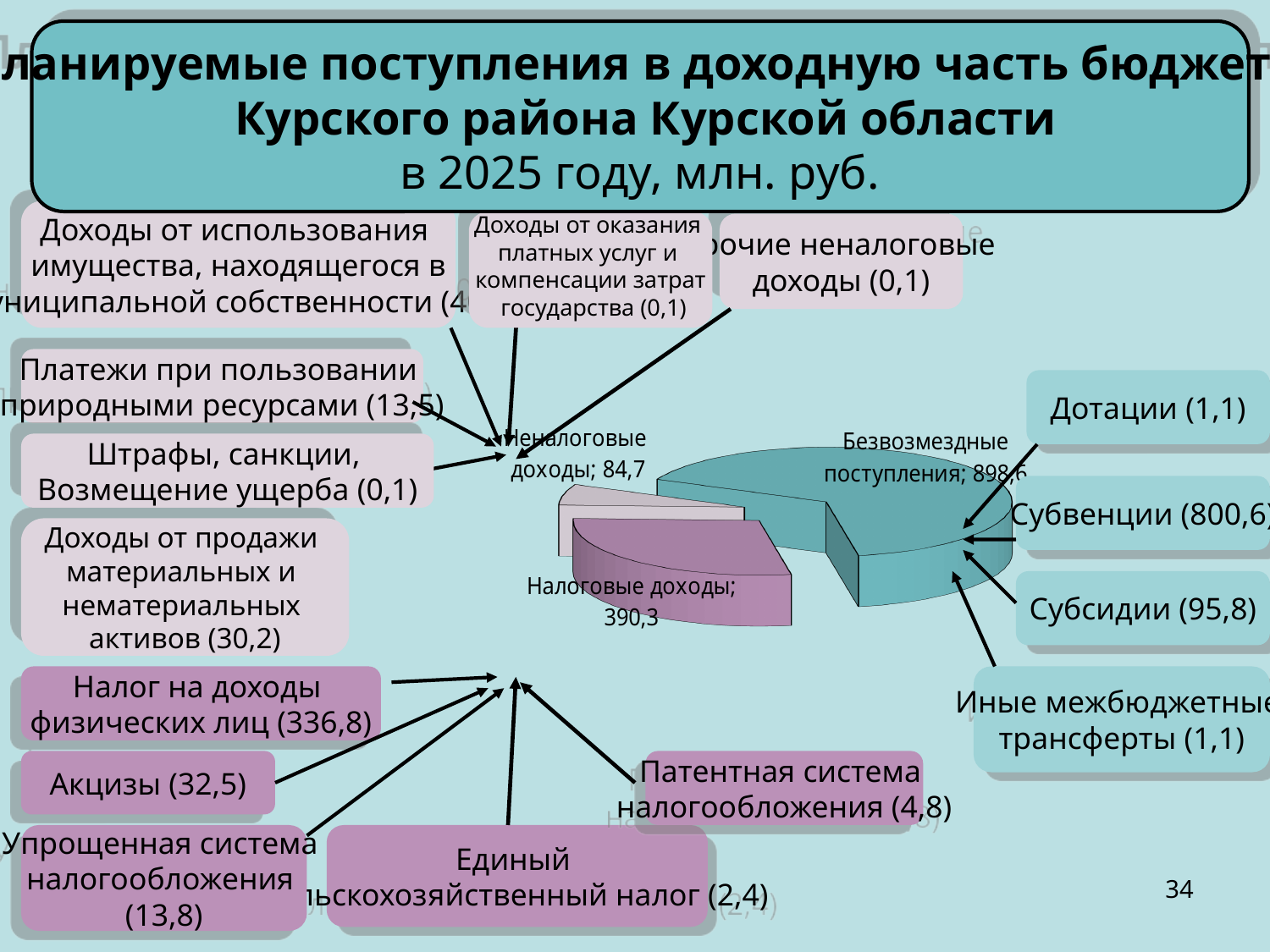
In what units are the values on the chart given, according to the slide title? млн. руб. What is the value for Безвозмездные поступления on the pie chart? 898,6 What is the difference between Безвозмездные поступления and Налоговые доходы on the pie chart? 508,3 Which is larger on the pie chart: Налоговые доходы or Неналоговые доходы? Налоговые доходы How many slices does the pie chart have? 3 What is the value for Неналоговые доходы on the pie chart? 84,7 What is the value for Налоговые доходы on the pie chart? 390,3 What kind of chart is shown on the slide? Pie chart What is the difference between Налоговые доходы and Неналоговые доходы on the pie chart? 305,6 Which slice of the pie chart has the largest value? Безвозмездные поступления Which slice of the pie chart has the smallest value? Неналоговые доходы What is the total of the three slices shown on the pie chart? 1373,6